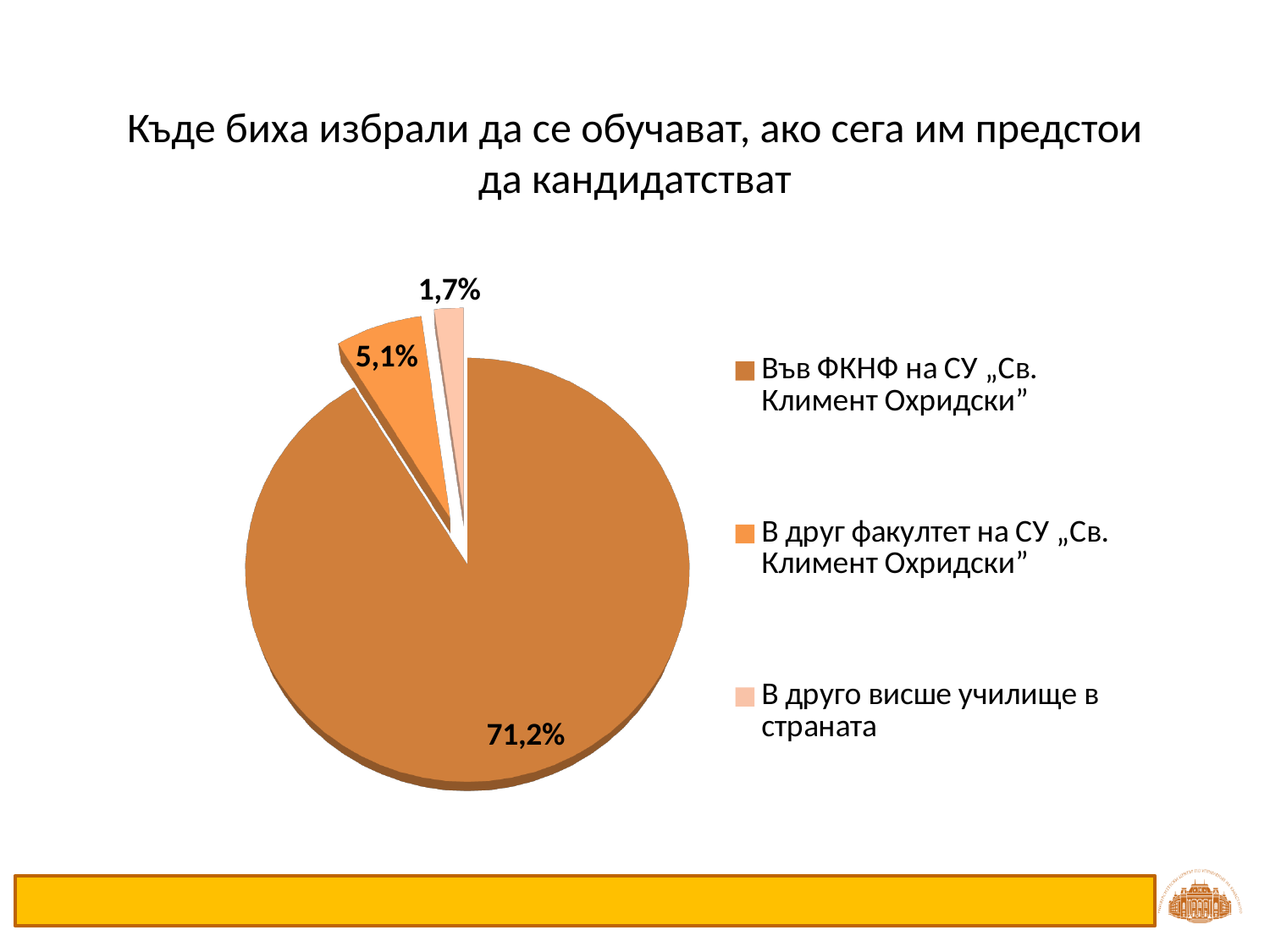
Which category has the smallest slice of the pie? В друго висше училище в страната How many slices does the pie chart have? 3 What kind of chart is shown on the slide? Pie chart What percentage is shown for "В друго висше училище в страната"? 1,7% What percentage is shown for "Във ФКНФ на СУ „Св. Климент Охридски”"? 71,2% How many entries does the legend list? 3 What percentage is shown for "В друг факултет на СУ „Св. Климент Охридски”"? 5,1% What is the difference between the values for "Във ФКНФ на СУ „Св. Климент Охридски”" and "В друг факултет на СУ „Св. Климент Охридски”"? 66,1% Which is larger: the slice for "В друг факултет на СУ „Св. Климент Охридски”" or the slice for "В друго висше училище в страната"? В друг факултет на СУ „Св. Климент Охридски” What is the title of the chart? Къде биха избрали да се обучават, ако сега им предстои да кандидатстват Which category has the largest slice of the pie? Във ФКНФ на СУ „Св. Климент Охридски” What is the difference between the values for "В друг факултет на СУ „Св. Климент Охридски”" and "В друго висше училище в страната"? 3,4%